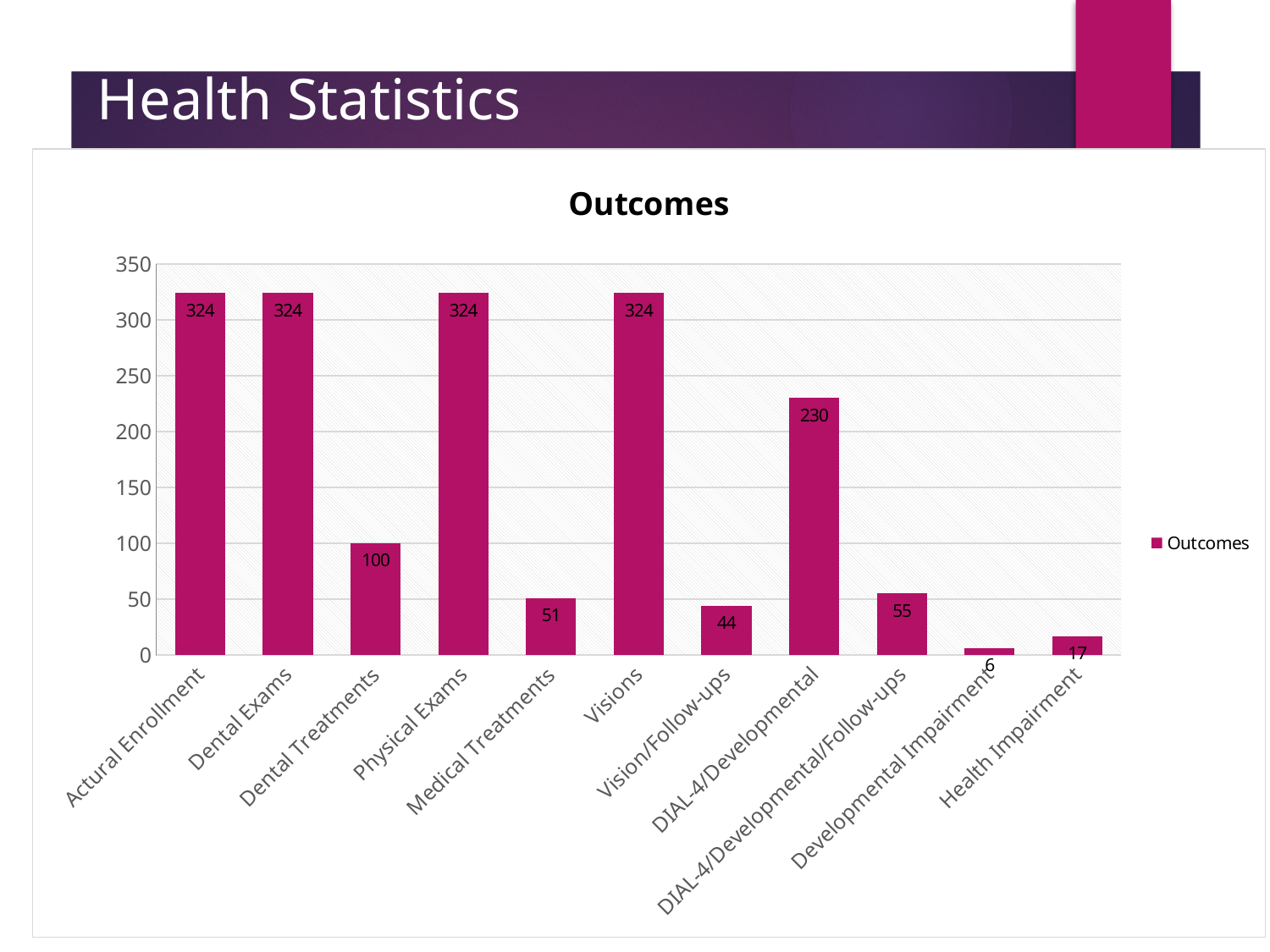
What is the title of the chart? Outcomes What is the value for Dental Treatments? 100 How many series does the legend list? 1 What is the value for Health Impairment? 17 Which is larger, Medical Treatments or Vision/Follow-ups? Medical Treatments What is the difference between Dental Exams and Dental Treatments? 224 What is the value for DIAL-4/Developmental? 230 What is the difference between DIAL-4/Developmental and DIAL-4/Developmental/Follow-ups? 175 What is the value for Vision/Follow-ups? 44 What kind of chart is shown? Bar chart Which category has the lowest value? Developmental Impairment How many categories are shown on the x axis? 11